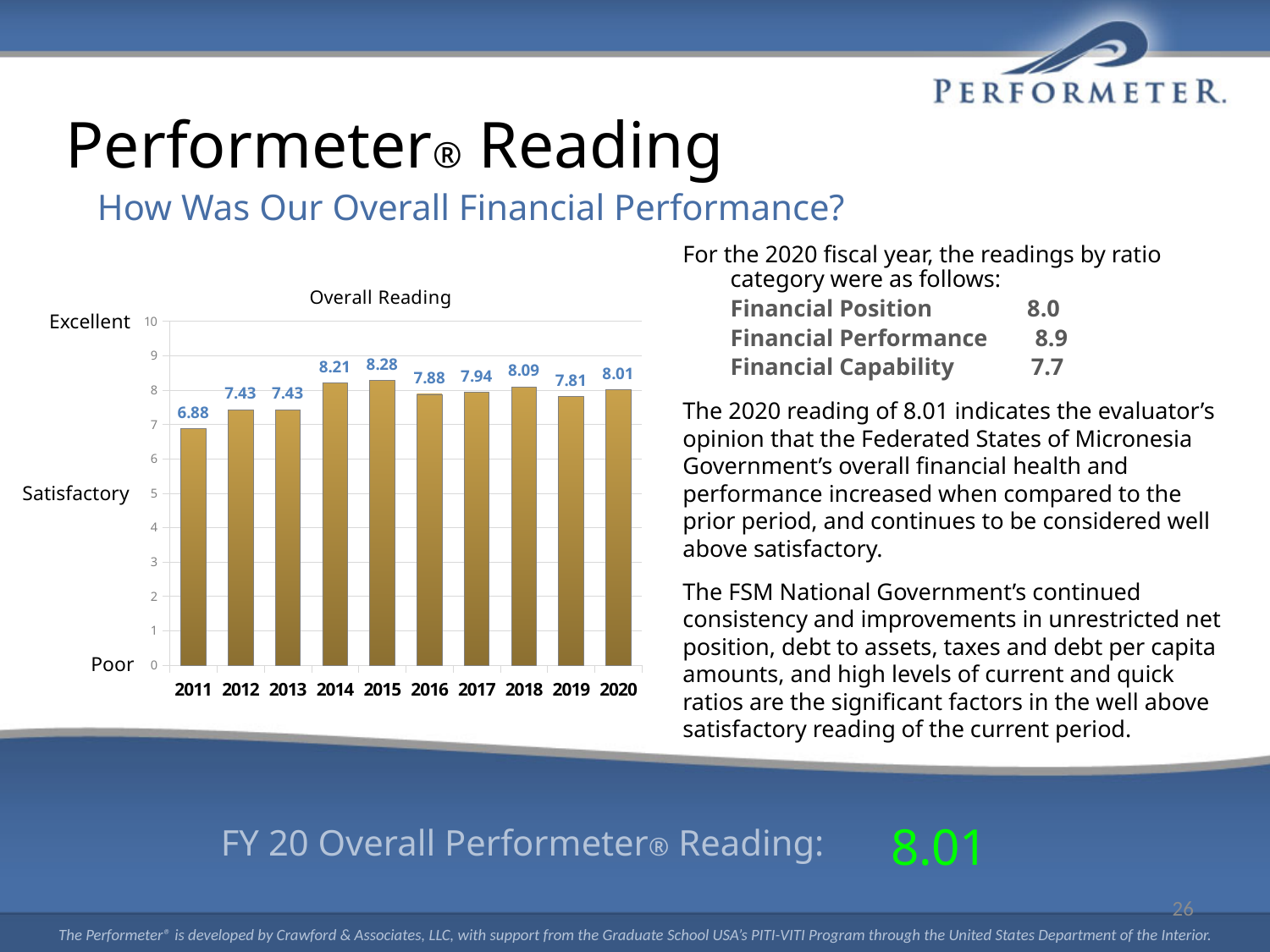
Which year has the highest Overall Reading? 2015 What is the difference between the Overall Reading for 2015 and 2011? 1.40 How many years are shown on the x axis of the Overall Reading chart? 10 Is the Overall Reading for 2014 greater or less than 8? greater What is the Overall Reading value for 2011? 6.88 Which year has the lowest Overall Reading? 2011 What is the Overall Reading value for 2016? 7.88 What is the difference between the Overall Reading for 2020 and 2019? 0.20 Which year has a higher Overall Reading, 2018 or 2019? 2018 What label appears at the top of the y axis (value 10) on the Overall Reading chart? Excellent What kind of chart is the Overall Reading chart? bar chart What is the Overall Reading value for 2020? 8.01